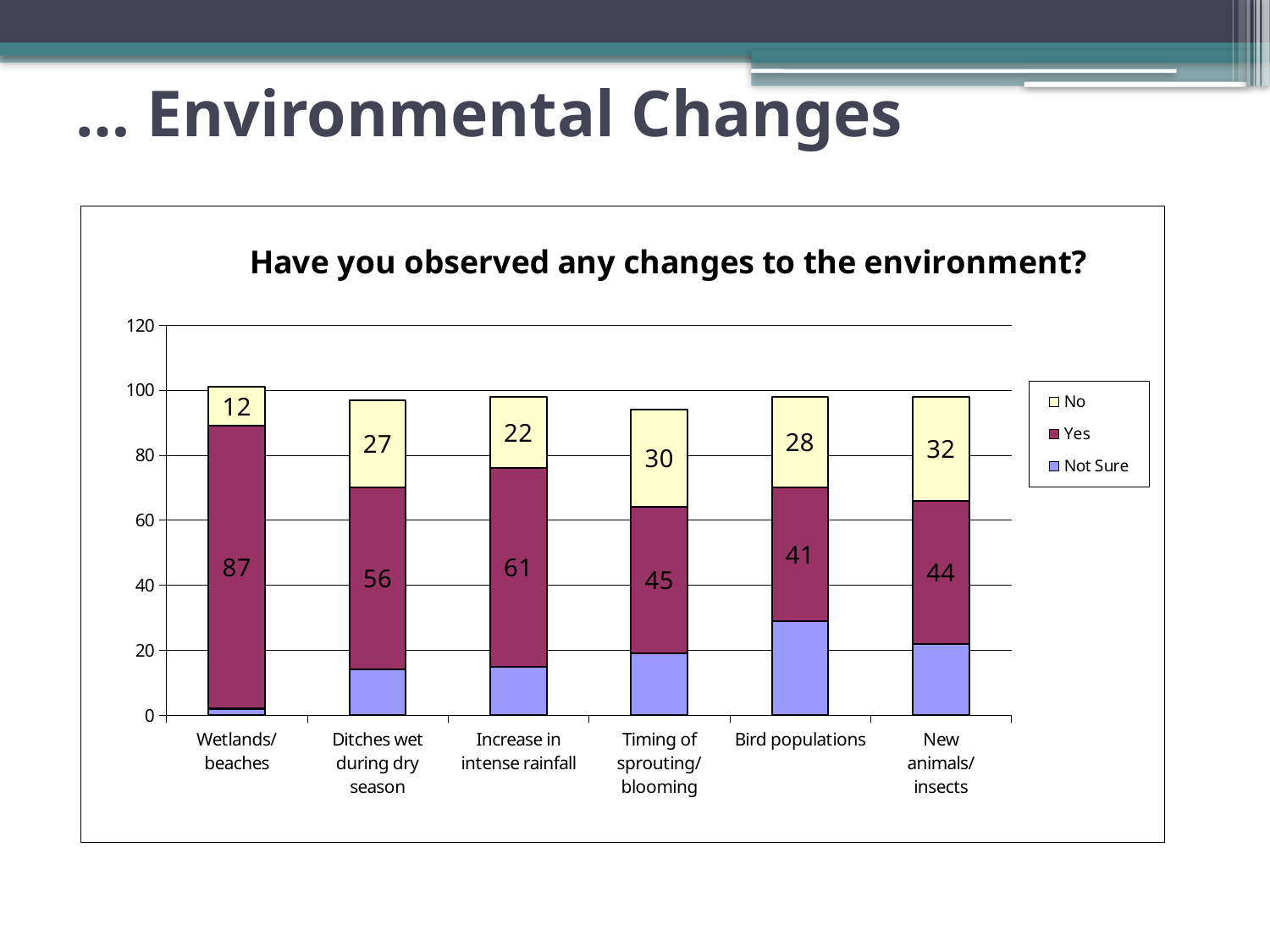
Which category has the lowest No value? Wetlands/beaches What kind of chart is shown on the slide? Stacked bar chart Which is larger, the No value for Bird populations or the No value for Ditches wet during dry season? Bird populations Is the Not Sure value for Bird populations greater or less than 20? greater Which category has the highest Yes value? Wetlands/beaches What is the Yes value for Timing of sprouting/blooming? 45 How many categories are shown on the x axis? 6 What is the title of the chart? Have you observed any changes to the environment? What is the Yes value for Wetlands/beaches? 87 How many series does the legend list? 3 What is the No value for New animals/insects? 32 What is the difference between the Yes values for Increase in intense rainfall and Ditches wet during dry season? 5